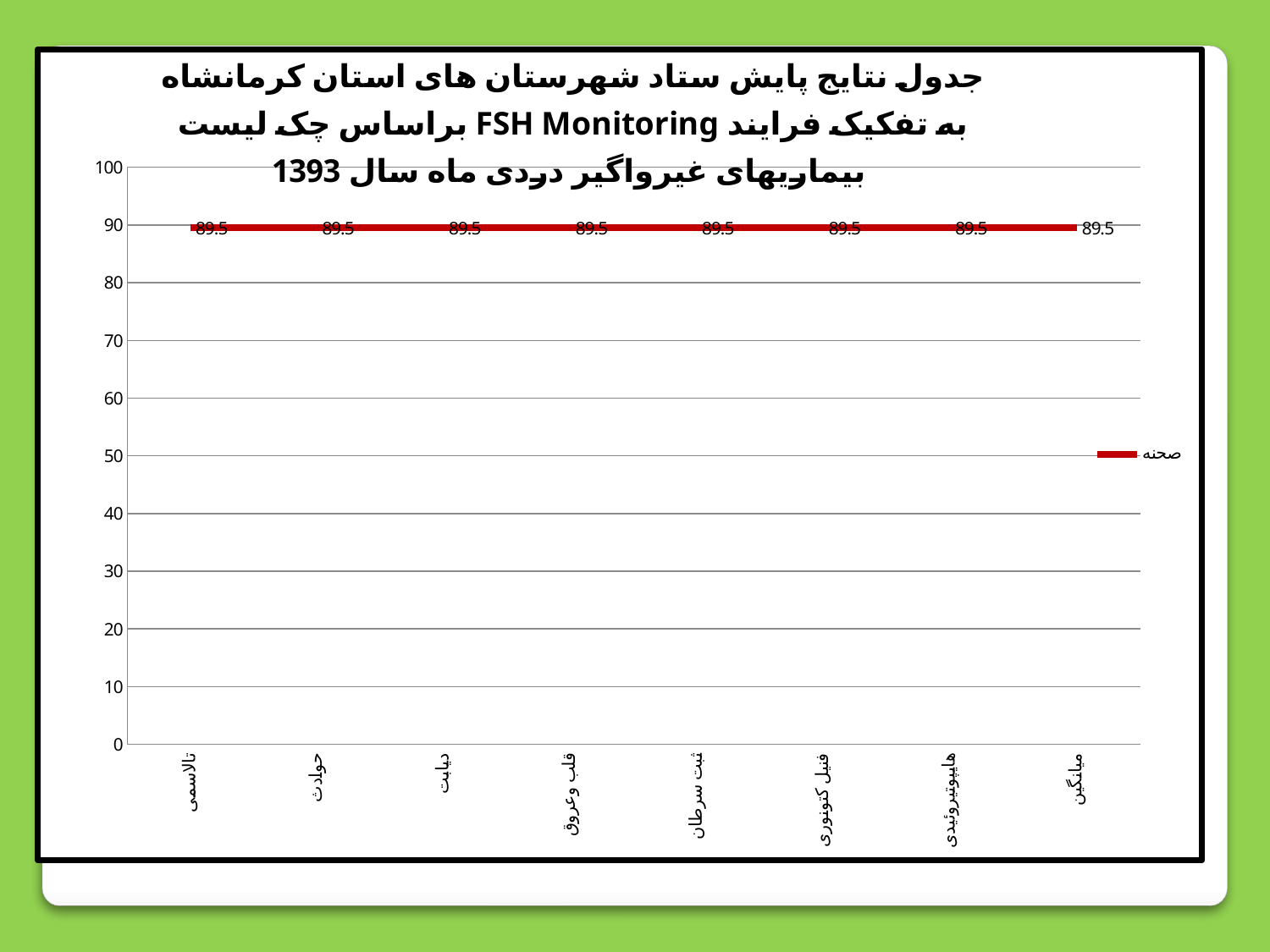
How many series does the legend list? 1 What is the difference between the values for حوادث and فنیل کتونوری? 0 How many categories are shown along the x axis? 8 What is the name of the series shown in the legend? صحنه Do the values rise, fall, or stay flat across the categories from تالاسمی to میانگین? stay flat What is the value for میانگین? 89.5 What kind of chart is shown on the slide? line chart What is the value for ثبت سرطان? 89.5 What is the value for تالاسمی? 89.5 Is the value for قلب وعروق greater or less than 80? greater What is the value for هایپوتیروئیدی? 89.5 What is the value for دیابت? 89.5